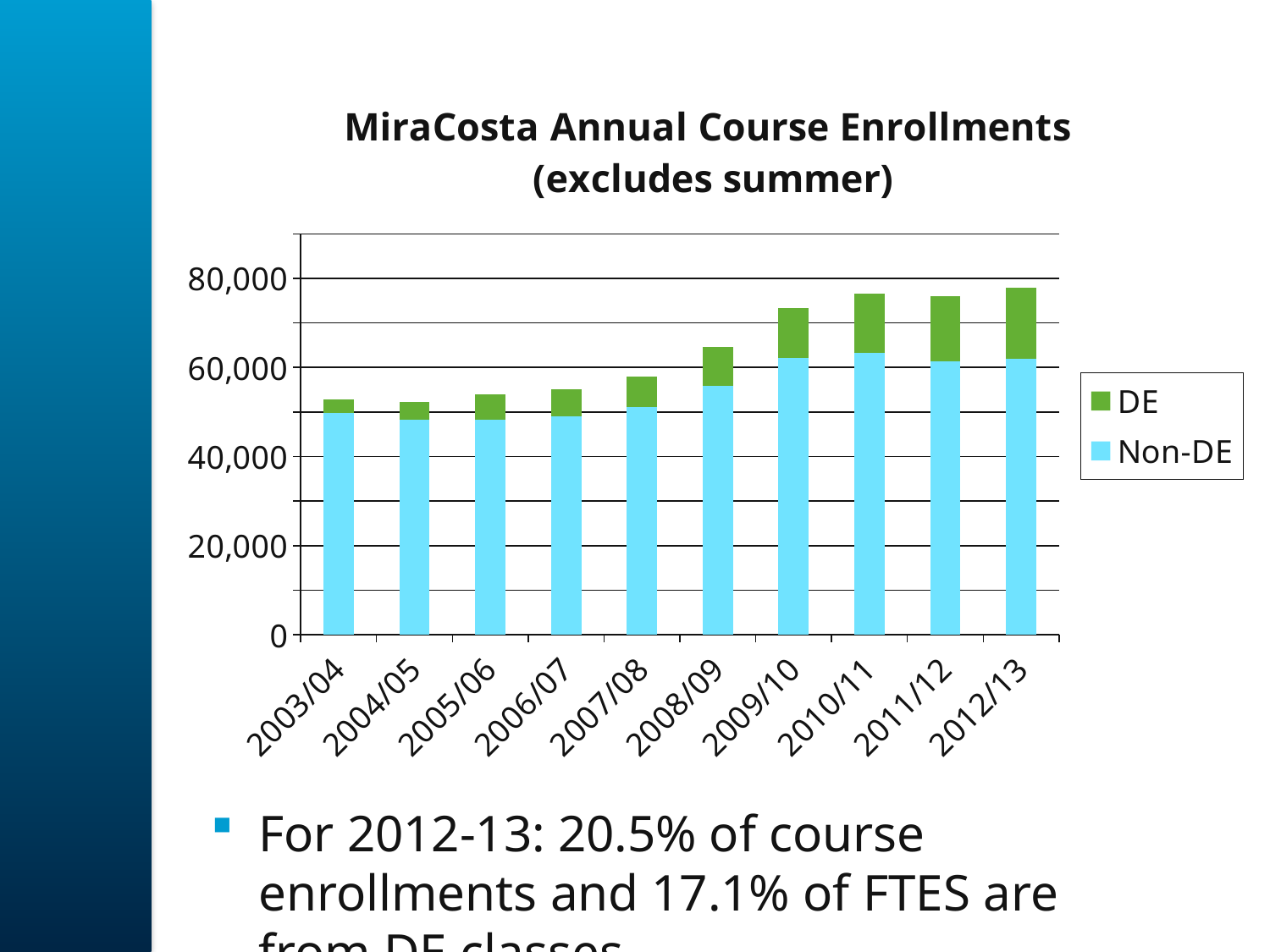
Is the Non-DE enrollment for 2010/11 greater or less than 60,000? greater How many academic years are shown on the x axis of the chart? 10 Which two series are listed in the chart's legend? DE and Non-DE Is the total enrollment for 2012/13 greater or less than 70,000? greater How many series does the chart's legend list? 2 Is the total enrollment for 2003/04 greater or less than 60,000? less What is the title of the chart? MiraCosta Annual Course Enrollments (excludes summer) Do total course enrollments generally rise or fall from 2003/04 to 2012/13? rise What kind of chart is shown on the slide? stacked bar chart Which year has the larger DE enrollment, 2005/06 or 2012/13? 2012/13 Which year has the larger total enrollment, 2003/04 or 2009/10? 2009/10